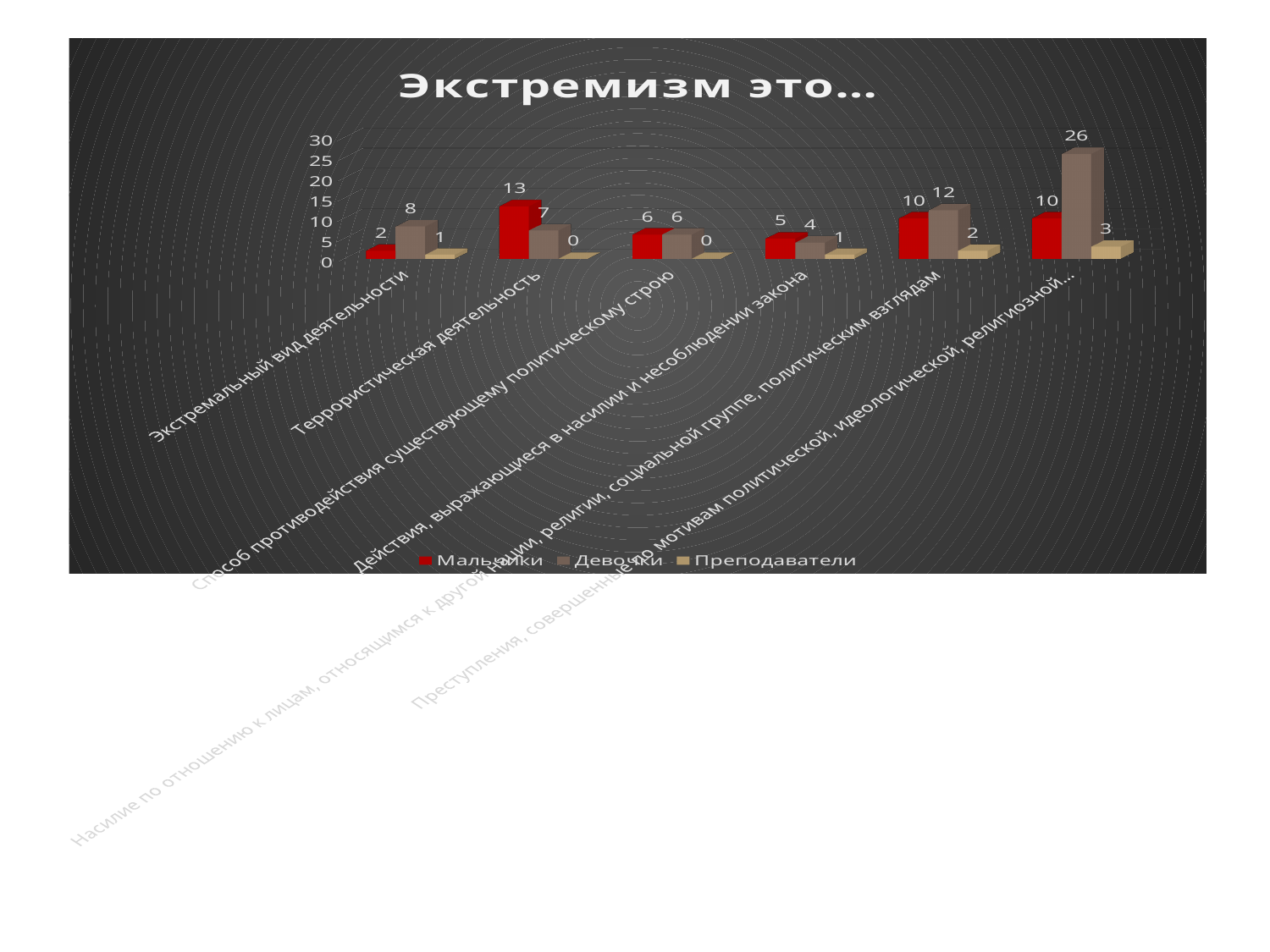
How many series does the legend list? 3 Which is larger in the category Террористическая деятельность: the value for Мальчики or for Девочки? Мальчики What kind of chart is shown on the slide? bar chart What is the value for Преподаватели in the category Действия, выражающиеся в насилии и несоблюдении закона? 1 What is the difference between the Девочки and Мальчики values in the category Преступления, совершенные по мотивам политической, идеологической, религиозной…? 16 What is the value for Девочки in the category Экстремальный вид деятельности? 8 What is the total of the three series in the category Насилие по отношению к лицам, относящимся к другой нации, религии, социальной группе, политическим взглядам? 24 What is the value for Мальчики in the category Террористическая деятельность? 13 In which category does the Мальчики series have its lowest value? Экстремальный вид деятельности In which category does the Девочки series reach its highest value? Преступления, совершенные по мотивам политической, идеологической, религиозной… How many categories are shown on the x axis? 6 What is the title of the chart? Экстремизм это…